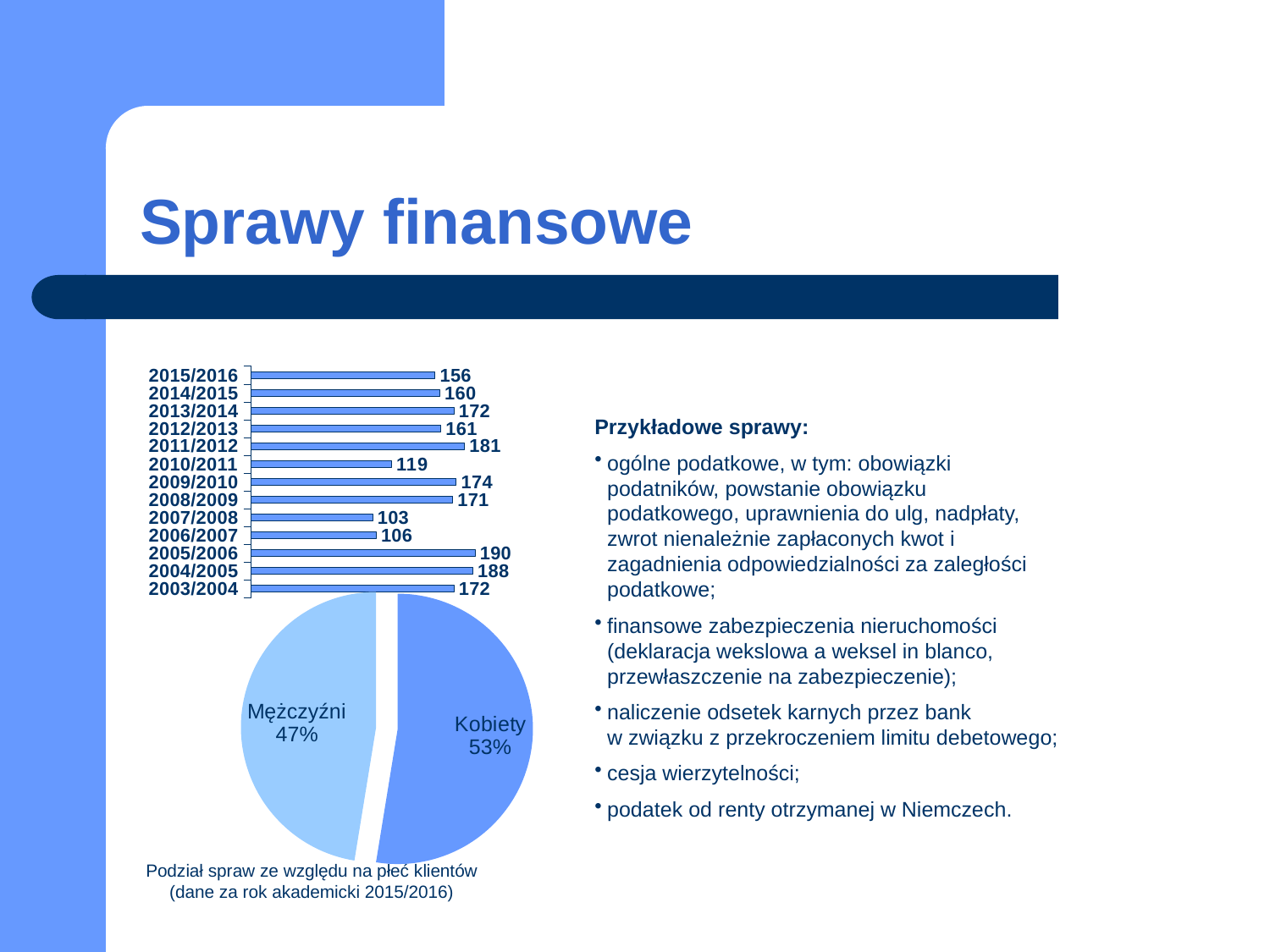
In the bar chart at the top left, what is the value for 2015/2016? 156 In the bar chart at the top left, which is larger, the value for 2011/2012 or the value for 2012/2013? 2011/2012 In the bar chart at the top left, which academic year has the lowest value? 2007/2008 How many academic years are shown in the bar chart at the top left? 13 What kind of chart is the chart at the top left of the slide? bar chart In the bar chart at the top left, what is the value for 2010/2011? 119 In the pie chart at the bottom left, what share is labelled for Mężczyźni? 47% In the bar chart at the top left, which academic year has the highest value? 2005/2006 In the bar chart at the top left, what is the difference between the values for 2013/2014 and 2014/2015? 12 In the bar chart at the top left, what is the difference between the values for 2005/2006 and 2004/2005? 2 How many slices does the pie chart at the bottom left have? 2 In the pie chart at the bottom left, what share is labelled for Kobiety? 53%